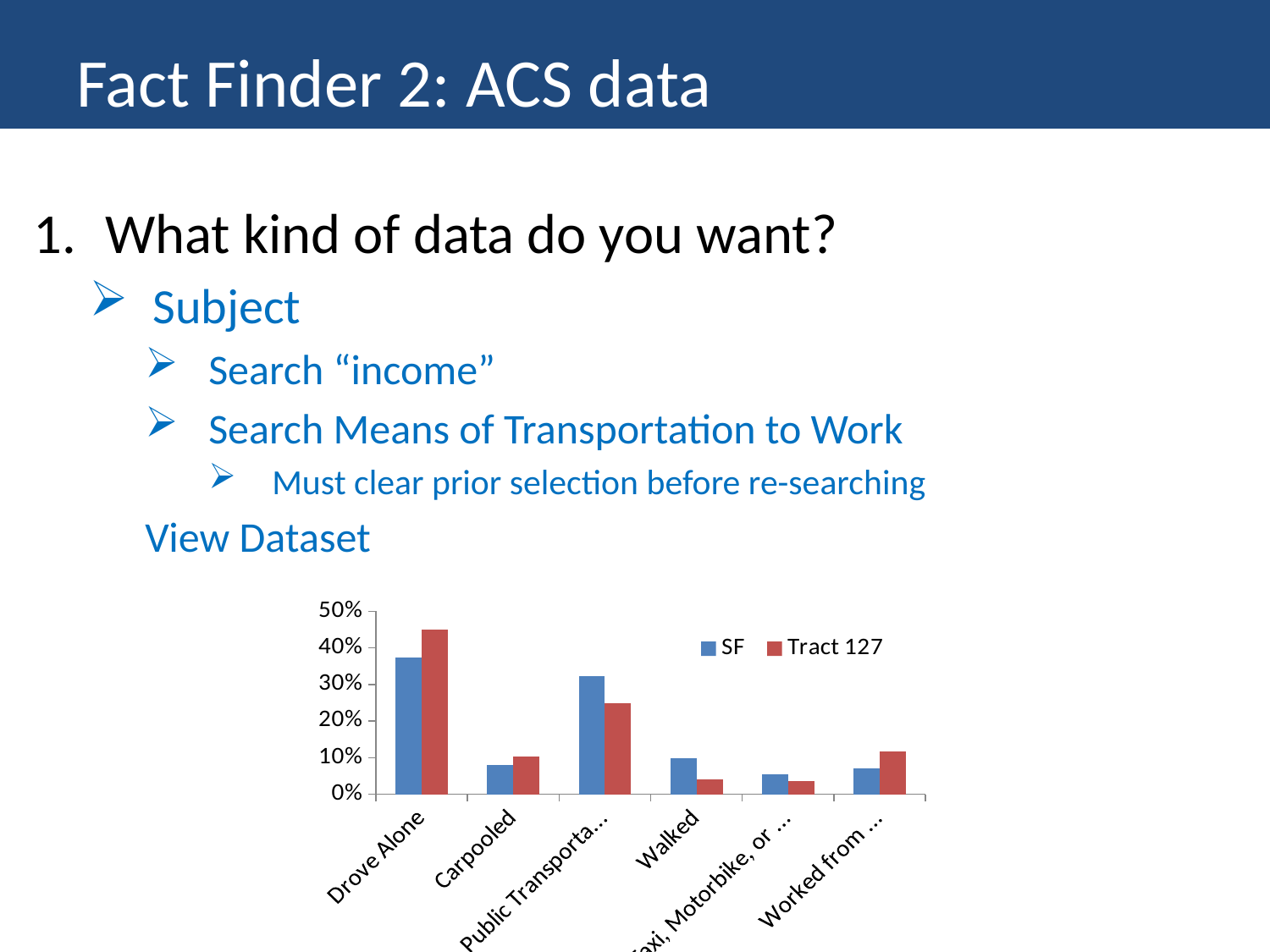
Is the SF value for Public Transportation greater or less than 30%? greater For Public Transportation, which series has the larger value, SF or Tract 127? SF How many categories are shown along the x axis of the chart? 6 How many series does the chart's legend list? 2 For Drove Alone, which series has the larger value, SF or Tract 127? Tract 127 What kind of chart is shown on the slide? bar chart For Walked, which series has the larger value, SF or Tract 127? SF Is the Tract 127 value for Drove Alone greater or less than 40%? greater Is the SF value for Carpooled greater or less than 10%? less Which category has the highest value for the Tract 127 series? Drove Alone Which category has the highest value for the SF series? Drove Alone What colour represents the Tract 127 series in the chart? red